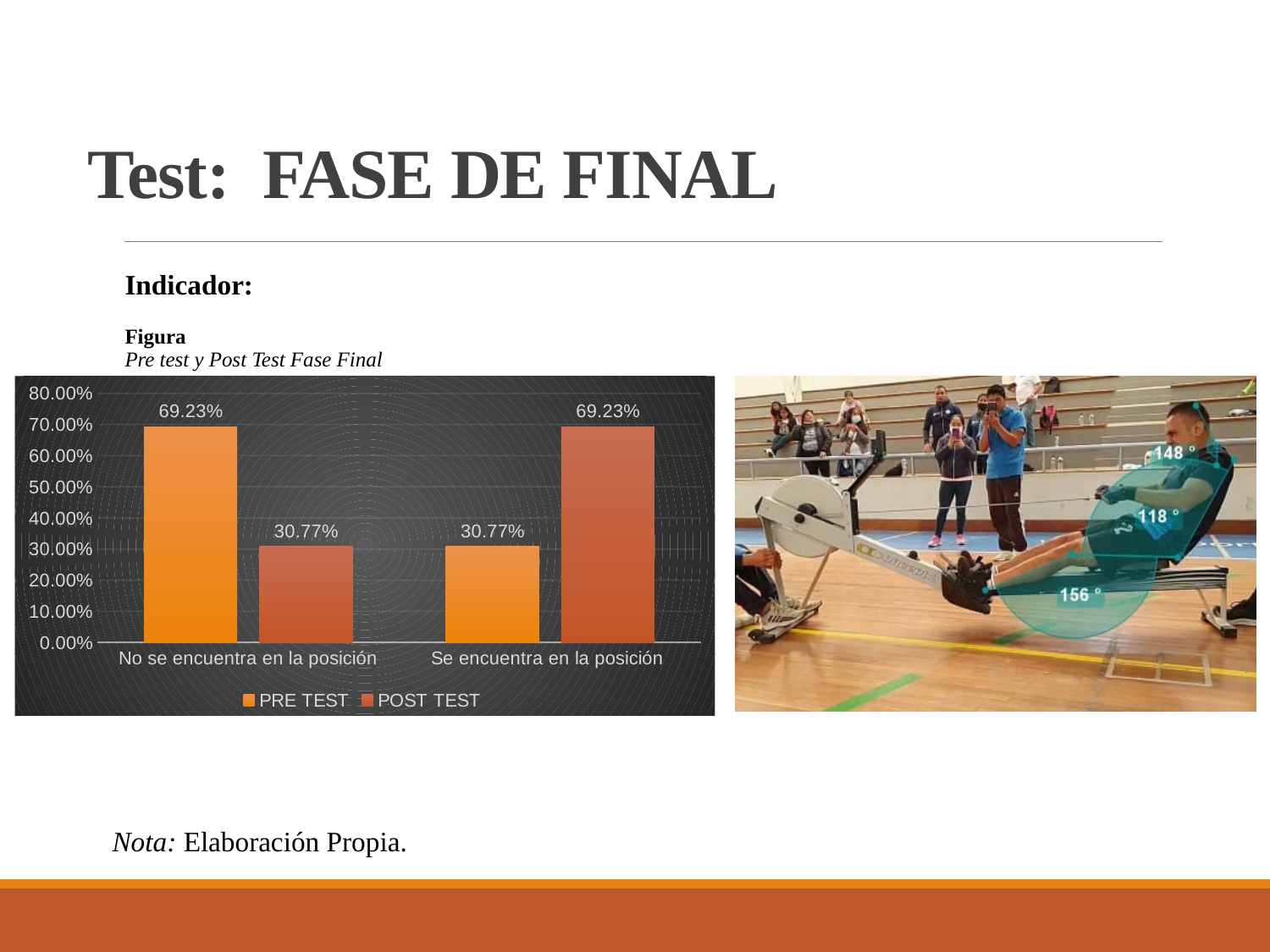
How many series does the legend list? 2 What is the difference between the PRE TEST and POST TEST values for "Se encuentra en la posición"? 38.46% For "No se encuentra en la posición", which is larger: PRE TEST or POST TEST? PRE TEST Which category has the highest POST TEST value? Se encuentra en la posición What is the PRE TEST value for "No se encuentra en la posición"? 69.23% Which category has the lowest PRE TEST value? Se encuentra en la posición What is the POST TEST value for "No se encuentra en la posición"? 30.77% What is the PRE TEST value for "Se encuentra en la posición"? 30.77% What are the two series named in the legend? PRE TEST and POST TEST What kind of chart is shown on the slide? Bar chart How many categories are shown on the x axis? 2 What is the POST TEST value for "Se encuentra en la posición"? 69.23%